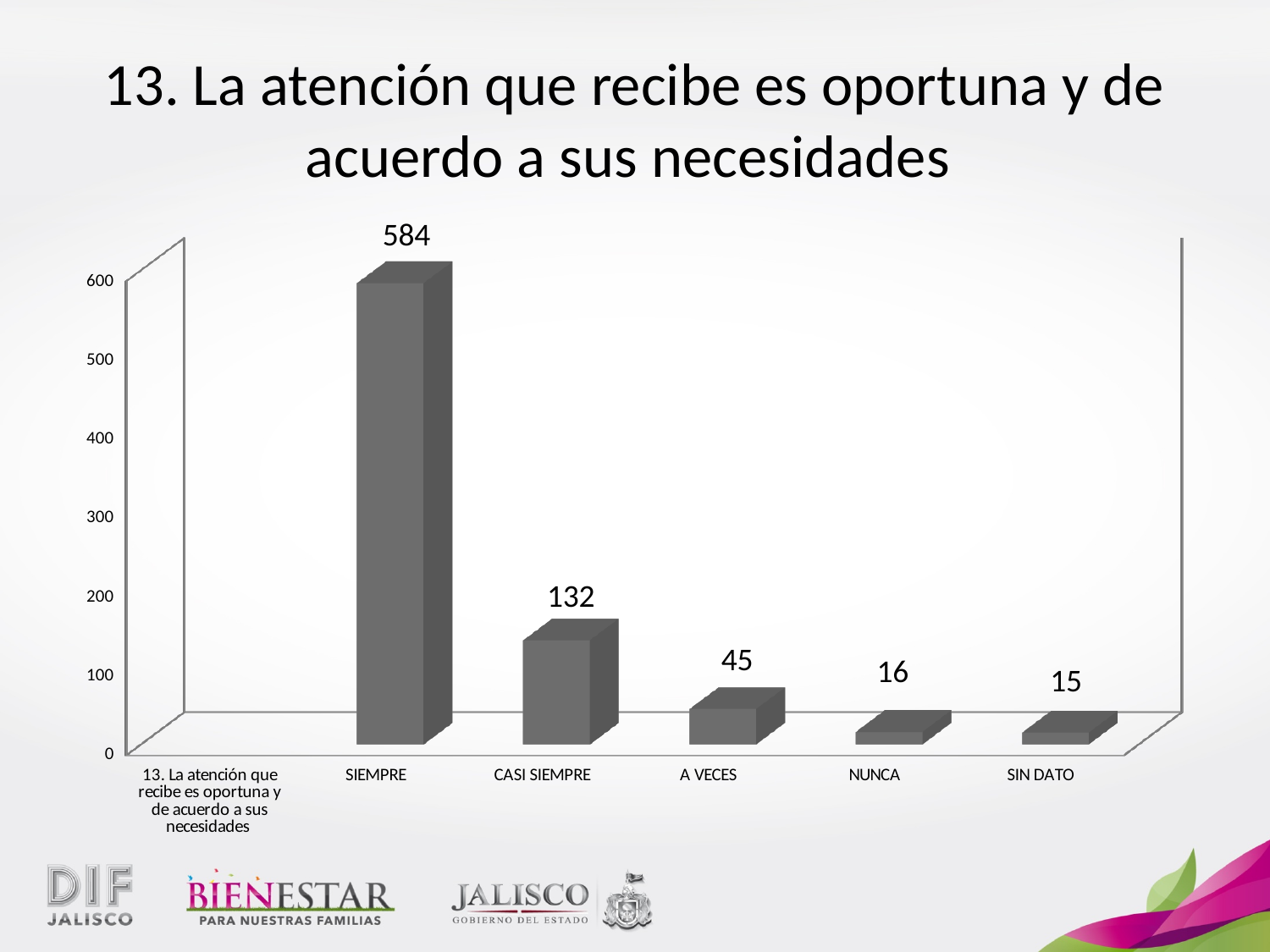
What is the value for SIEMPRE? 584 What is the value for CASI SIEMPRE? 132 What is the value for A VECES? 45 How many bars are plotted in the chart? 5 What kind of chart is shown on the slide? bar chart Which category has the lowest value? SIN DATO Is the value for SIEMPRE greater or less than 500? greater What is the value for NUNCA? 16 Which is larger, the value for A VECES or the value for NUNCA? A VECES What is the value for SIN DATO? 15 Which category has the highest value? SIEMPRE What is the difference between the values for SIEMPRE and CASI SIEMPRE? 452